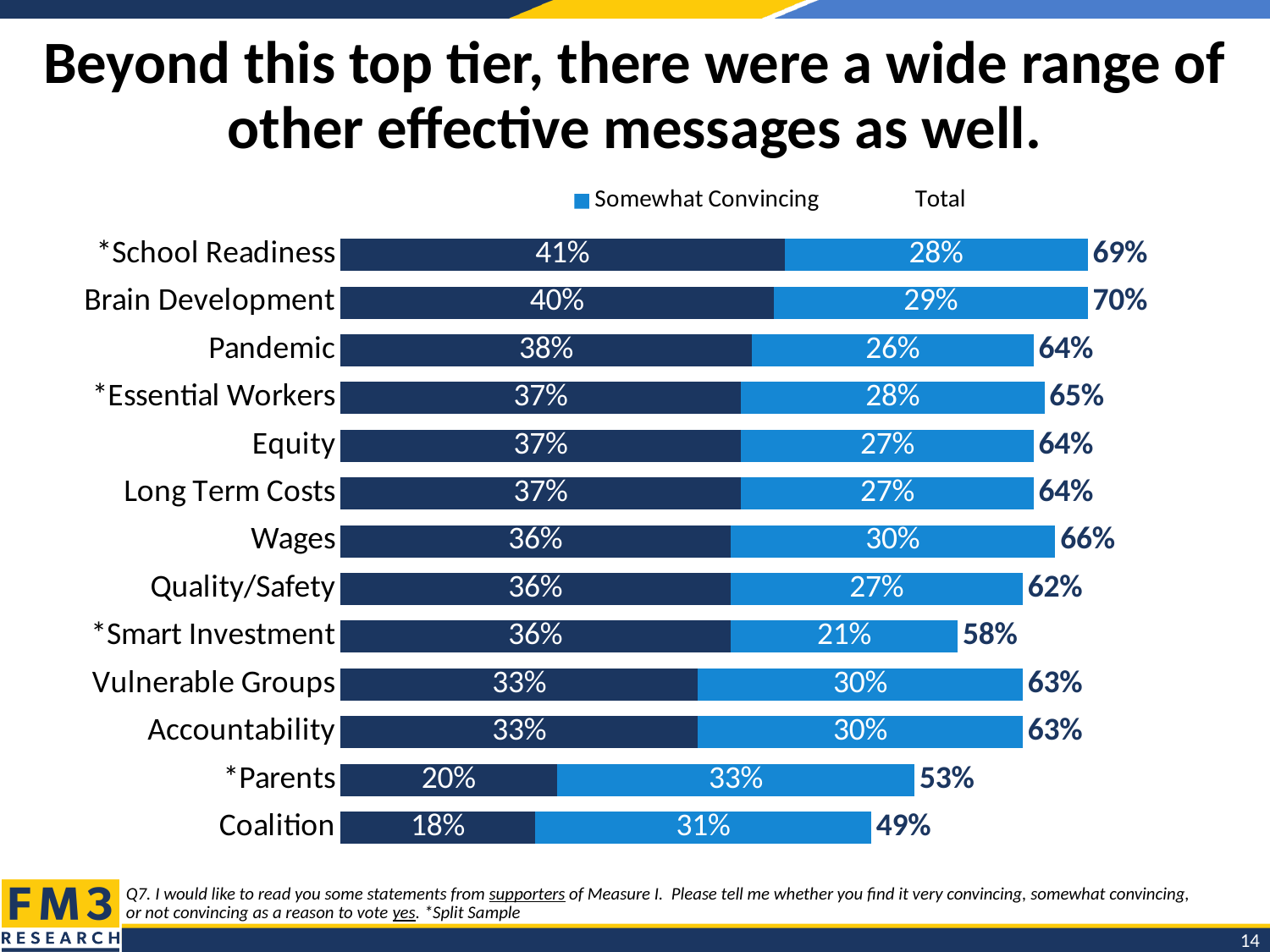
How many message categories are plotted in the chart? 13 What does the asterisk before some category names indicate, according to the footnote? Split Sample What is the value of the dark blue segment for *Smart Investment? 36% Which category has the highest Total value? Brain Development What is the Somewhat Convincing value for Wages? 30% Which category has the lowest Somewhat Convincing value? *Smart Investment What is the difference between the Total for *School Readiness and the Total for Pandemic? 5 percentage points Which category has the highest Somewhat Convincing value? *Parents What kind of chart is shown on the slide? Stacked bar chart Which category has the lowest Total value? Coalition Which has the larger Somewhat Convincing value, *Parents or Equity? *Parents What is the Total value shown for Brain Development? 70%